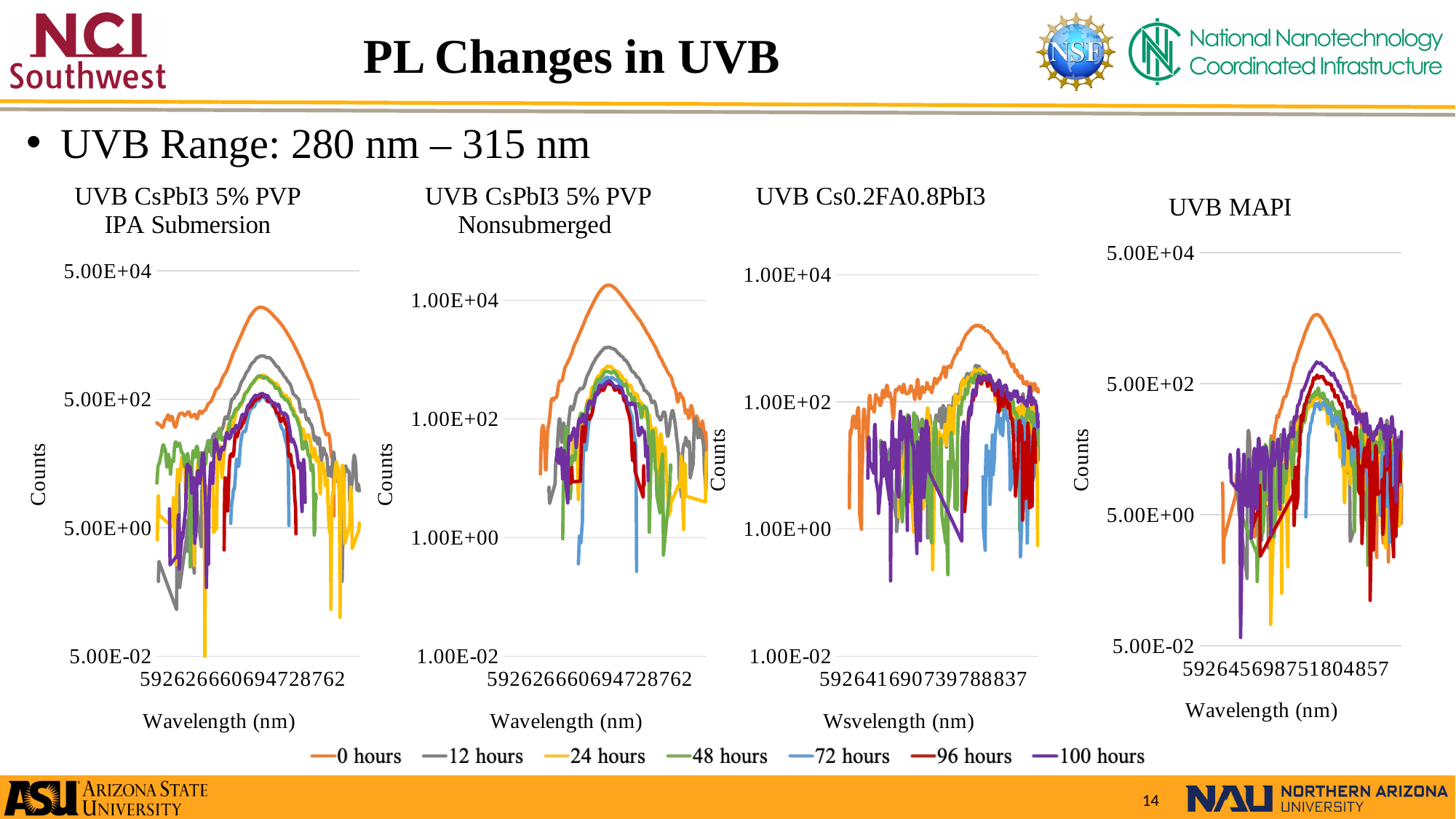
What kind of chart is the "UVB MAPI" chart? line chart In the "UVB MAPI" chart, which series reaches the highest peak? 0 hours What is the y-axis label on the "UVB MAPI" chart? Counts In the "UVB CsPbI3 5% PVP Nonsubmerged" chart, is the peak value of the 12 hours series greater or less than 1.00E+02? greater In the "UVB Cs0.2FA0.8PbI3" chart, is the peak value of the 0 hours series greater or less than 1.00E+04? less How many series does the shared legend at the bottom of the slide list? 7 In the "UVB CsPbI3 5% PVP IPA Submersion" chart, which series reaches the highest peak? 0 hours In the "UVB MAPI" chart, is the peak value of the 0 hours series greater or less than 5.00E+04? less Which colour represents the 0 hours series in the legend? orange In the "UVB CsPbI3 5% PVP Nonsubmerged" chart, which series reaches the highest peak? 0 hours How many charts are shown on the slide? 4